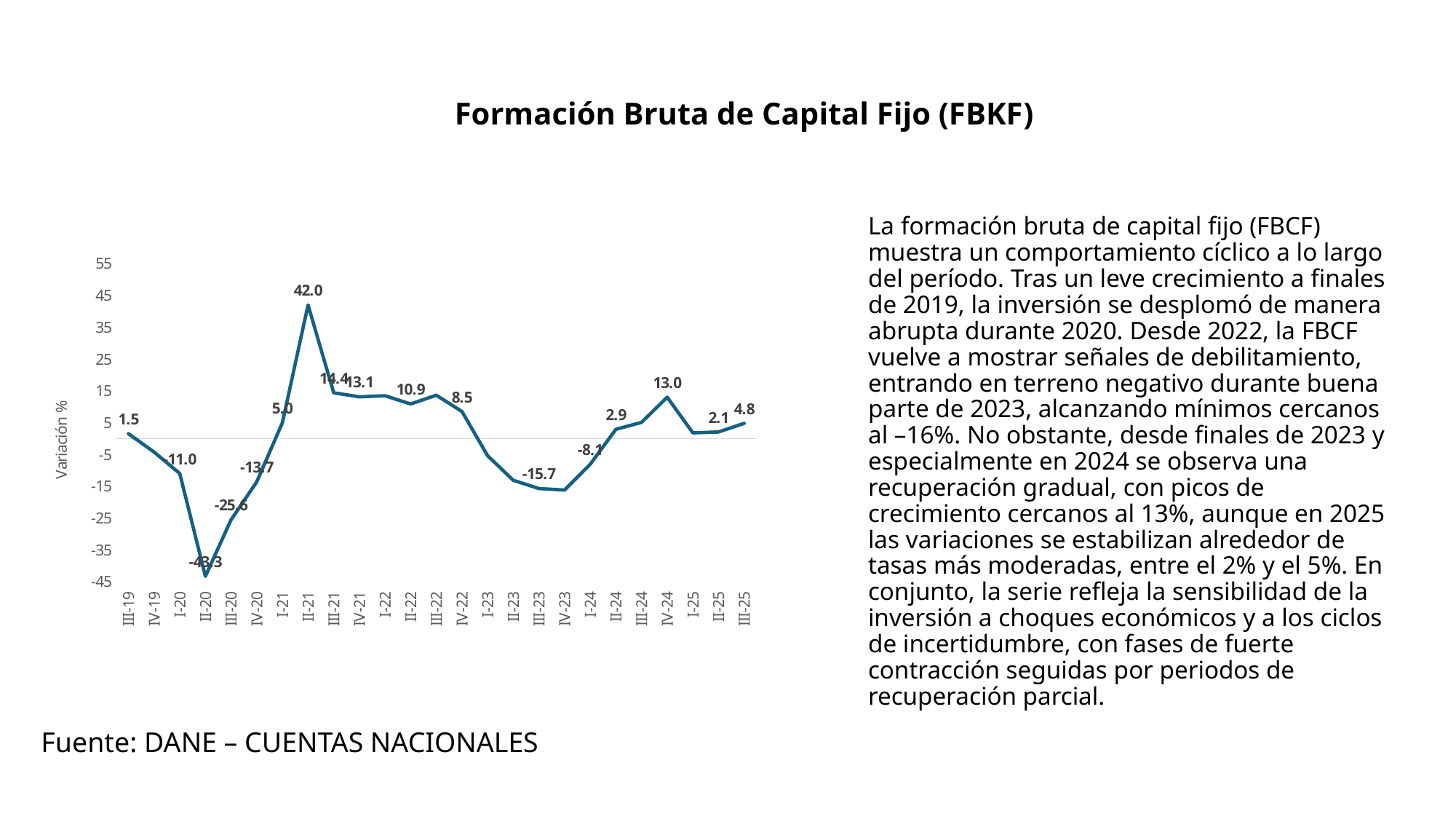
Which is larger, the value for IV-24 or the value for II-25? IV-24 What is the value for II-21? 42.0 Is the value for I-23 greater or less than 5? less What is the title of the chart? Formación Bruta de Capital Fijo (FBKF) Which quarter has the lowest value on the chart? II-20 How many quarterly data points are plotted on the chart? 25 What type of chart is shown on the slide? Line chart What is the value for III-25? 4.8 What is the label on the vertical axis of the chart? Variación % What is the value for III-23? -15.7 Which quarter has the highest value on the chart? II-21 What is the difference between the values for II-21 and IV-24? 29.0